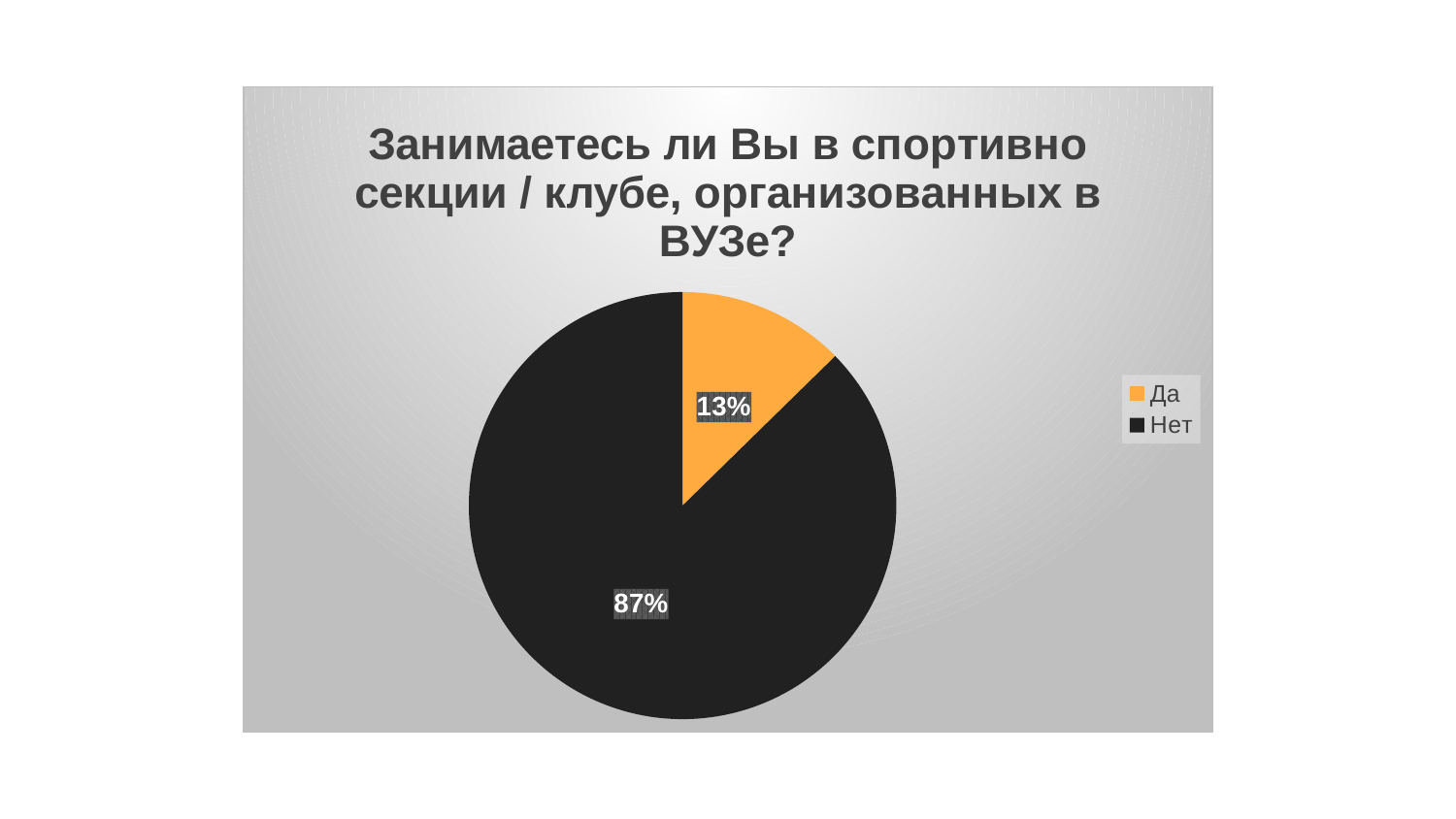
Which is larger, the share for "Да" or the share for "Нет"? Нет Which category has the smallest slice of the pie? Да What is the title of the chart? Занимаетесь ли Вы в спортивно секции / клубе, организованных в ВУЗе? What share of the pie does "Да" represent? 13% What share of the pie does "Нет" represent? 87% How many categories does the pie chart have? 2 Which category has the largest slice of the pie? Нет What colour is the slice for "Да"? orange What is the difference in percentage points between "Нет" and "Да"? 74 What type of chart is shown on the slide? pie chart How many entries does the legend list? 2